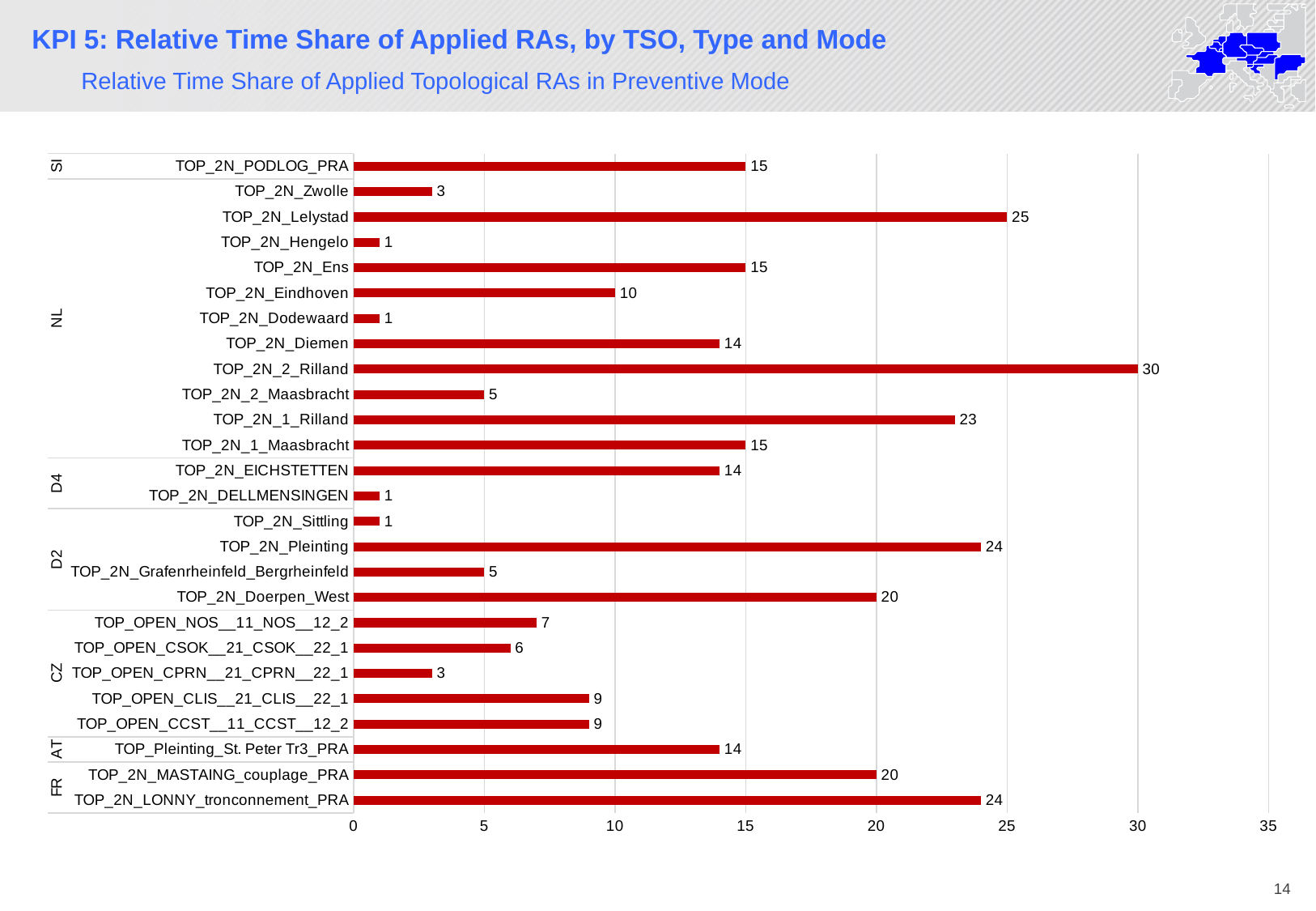
What is the value for TOP_2N_Lelystad? 25 Which is larger, the value for TOP_2N_Pleinting or the value for TOP_2N_Eindhoven? TOP_2N_Pleinting What is the difference between the values for TOP_2N_LONNY_tronconnement_PRA and TOP_2N_MASTAING_couplage_PRA? 4 What kind of chart is shown on the slide? bar chart What is the value for TOP_Pleinting_St. Peter Tr3_PRA? 14 What is the value for TOP_2N_Doerpen_West? 20 Is the value for TOP_2N_Diemen greater or less than 10? greater What is the lowest value shown on the chart? 1 What is the value for TOP_OPEN_CSOK__21_CSOK__22_1? 6 Which category has the highest value? TOP_2N_2_Rilland What is the difference between the values for TOP_2N_2_Rilland and TOP_2N_1_Rilland? 7 How many categories are plotted on the chart? 26